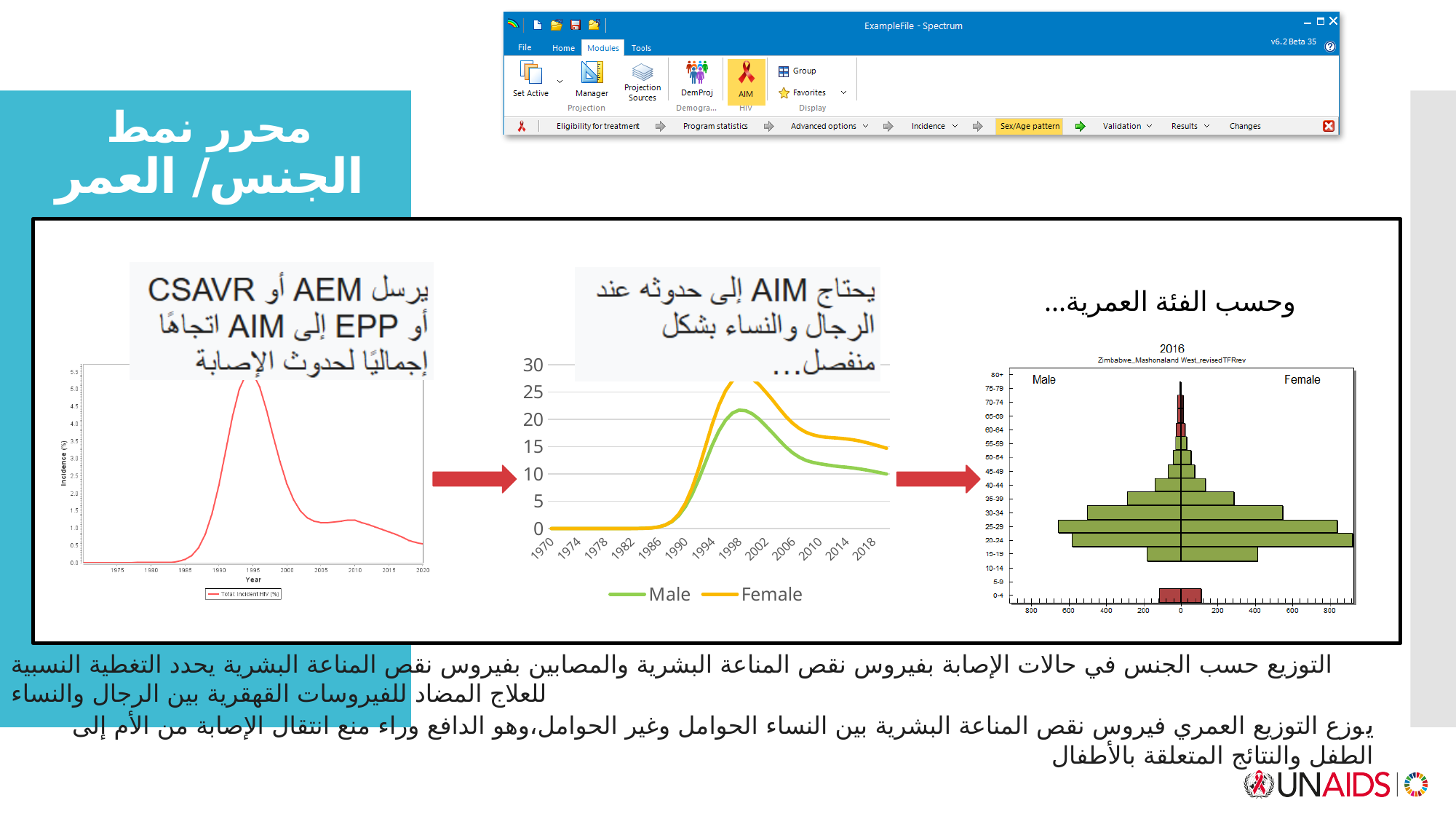
In the middle chart, is the Female value in 2018 greater or less than 10? greater In the left-hand Incidence (%) chart, is the value in 2020 greater or less than 1.0? less In the middle chart, do the Male and Female values rise or fall between 1998 and 2018? fall How many series does the legend of the middle chart list? 2 In the right-hand 2016 chart, which age group has the largest Female bar? 20-24 What kind of chart is the middle chart with the Male and Female lines? line chart In the right-hand 2016 chart, which age group has the largest Male bar? 25-29 How many age groups are shown on the vertical axis of the right-hand 2016 chart? 17 In the middle chart, is the peak of the Female line greater or less than 25? greater What kind of chart is the right-hand chart titled 2016 showing Male and Female by age group? bar chart In the middle chart, which series is higher in 2018, Male or Female? Female